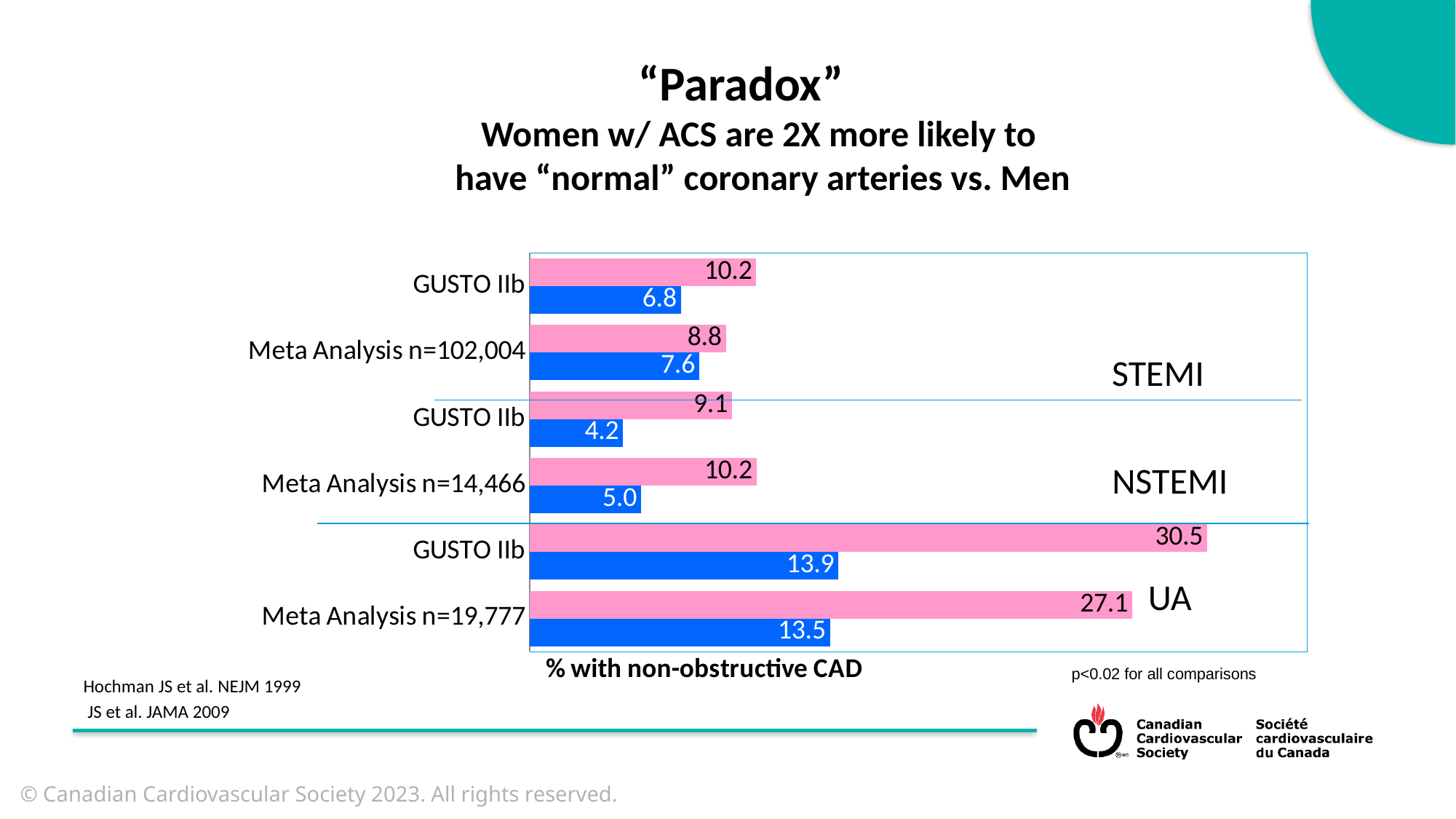
What kind of chart is shown on the slide? bar chart Which category has the highest pink bar value? GUSTO IIb (UA) What is the value of the pink bar for Meta Analysis n=102,004? 8.8 How many category rows are plotted on the chart? 6 What is the difference between the pink and blue bar values for Meta Analysis n=102,004? 1.2 Which category has the lowest blue bar value? GUSTO IIb (NSTEMI) What is the value of the pink bar for Meta Analysis n=19,777? 27.1 What is the x-axis label of the chart? % with non-obstructive CAD What is the value of the blue bar for Meta Analysis n=14,466? 5.0 What is the value of the blue bar for the GUSTO IIb row in the UA section? 13.9 What is the difference between the pink and blue bar values for the GUSTO IIb row in the UA section? 16.6 Which is larger for Meta Analysis n=19,777, the pink bar or the blue bar? pink bar